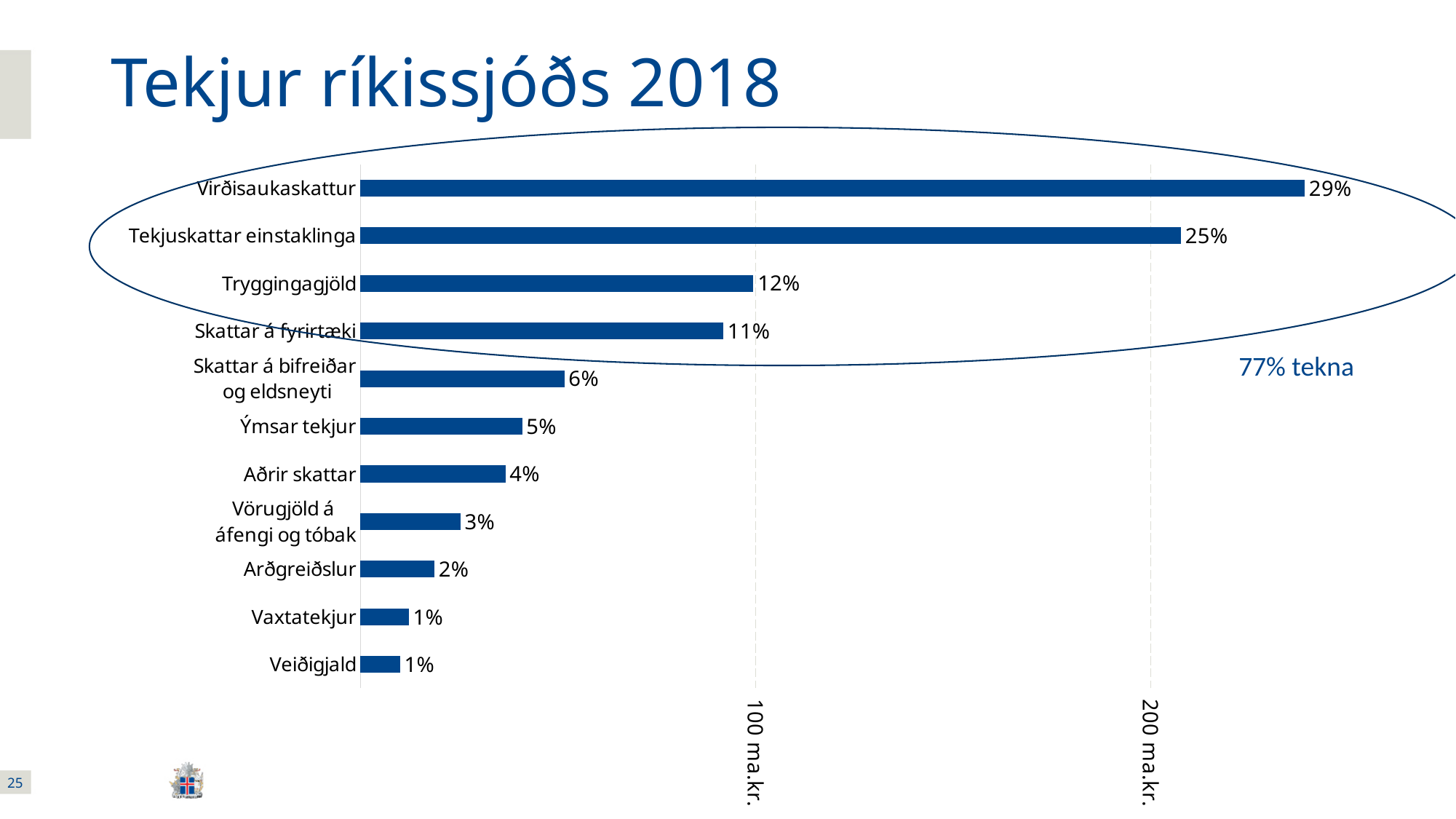
What is the data label shown for Virðisaukaskattur? 29% What is the data label shown for Arðgreiðslur? 2% What type of chart is shown on the slide? Bar chart What is the data label shown for Skattar á bifreiðar og eldsneyti? 6% Is the bar for Tryggingagjöld greater or less than 100 ma.kr.? less Which is larger, Tryggingagjöld or Skattar á fyrirtæki? Tryggingagjöld Is the bar for Virðisaukaskattur greater or less than 200 ma.kr.? greater What is the data label shown for Tryggingagjöld? 12% How many categories are shown in the chart? 11 Which category has the highest value? Virðisaukaskattur What is the difference in percentage points between the labels for Virðisaukaskattur (29%) and Tekjuskattar einstaklinga (25%)? 4 percentage points What is the data label shown for Tekjuskattar einstaklinga? 25%